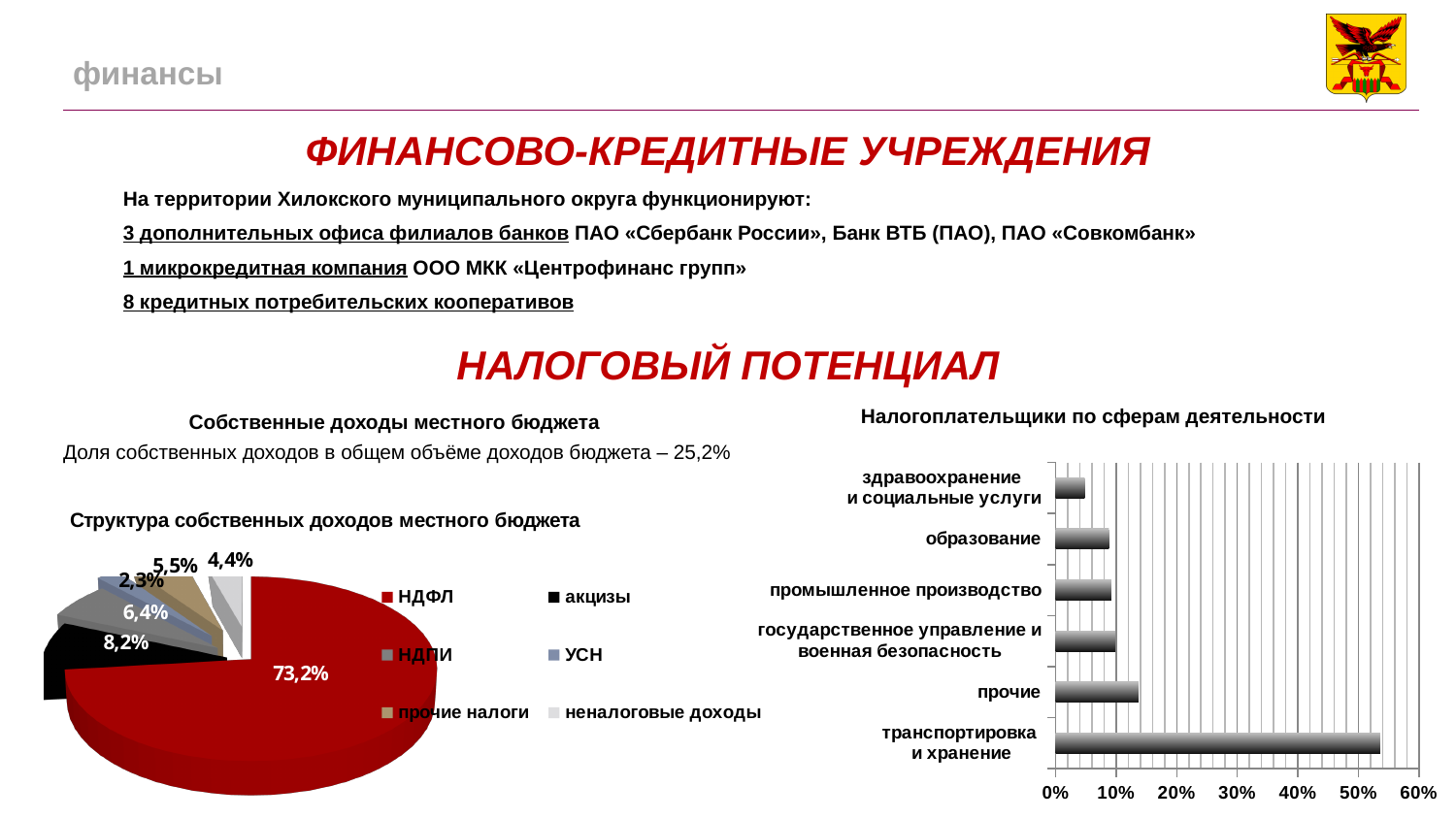
In the pie chart 'Структура собственных доходов местного бюджета', which category has the largest share? НДФЛ In the bar chart 'Налогоплательщики по сферам деятельности', how many categories are shown? 6 In the bar chart 'Налогоплательщики по сферам деятельности', is the value for транспортировка и хранение greater or less than 50%? greater In the pie chart 'Структура собственных доходов местного бюджета', how many categories does the legend list? 6 What kind of chart is 'Налогоплательщики по сферам деятельности'? bar chart In the bar chart 'Налогоплательщики по сферам деятельности', which category has the lowest value? здравоохранение и социальные услуги In the pie chart 'Структура собственных доходов местного бюджета', which is larger: прочие налоги or неналоговые доходы? прочие налоги In the pie chart 'Структура собственных доходов местного бюджета', what share is shown for НДФЛ? 73,2% In the pie chart 'Структура собственных доходов местного бюджета', which category has the smallest share? УСН In the bar chart 'Налогоплательщики по сферам деятельности', which category has the highest value? транспортировка и хранение In the pie chart 'Структура собственных доходов местного бюджета', what is the difference between the shares of НДФЛ and акцизы? 65,0% In the pie chart 'Структура собственных доходов местного бюджета', what share is shown for акцизы? 8,2%